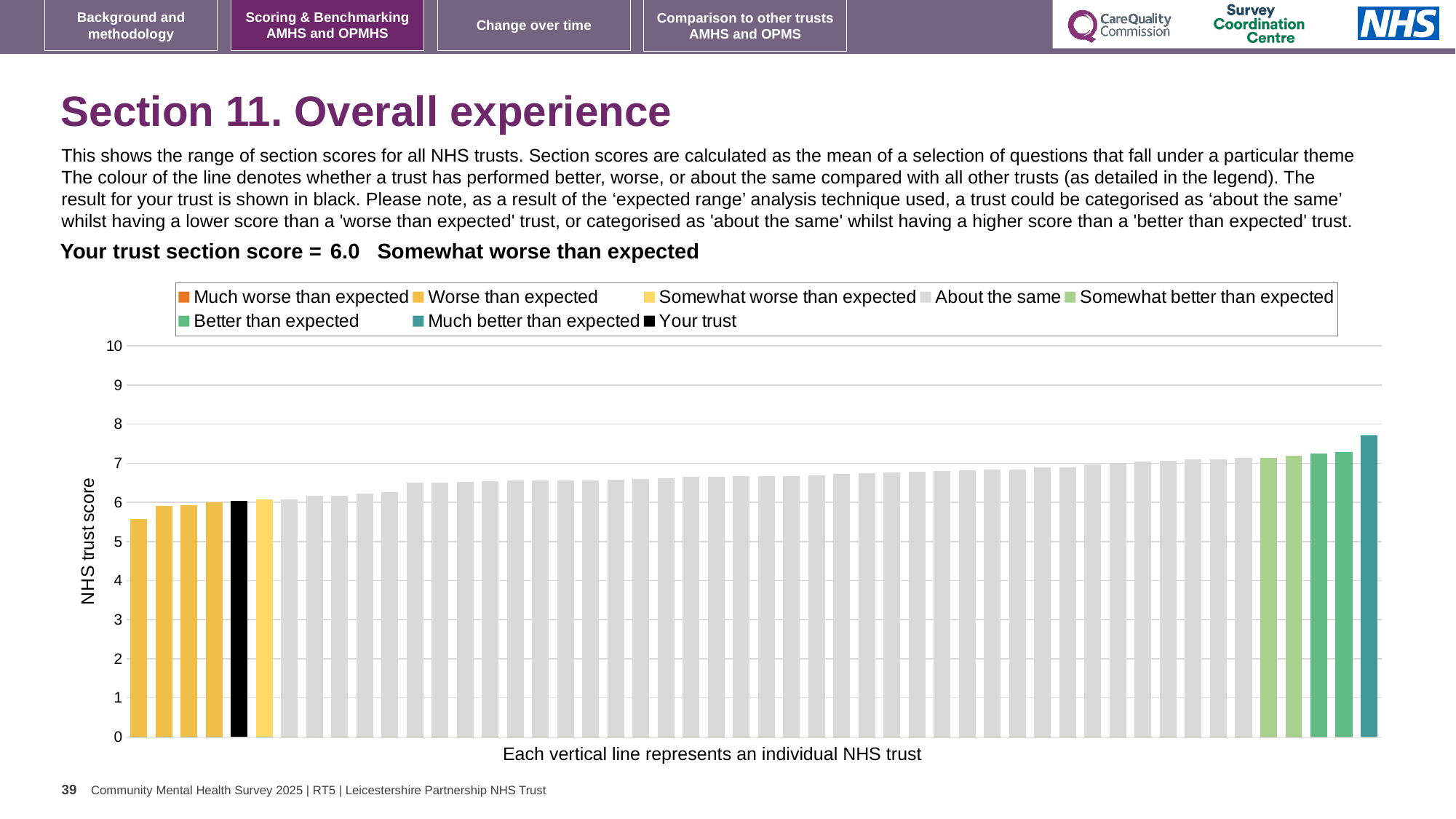
Is the value of the leftmost bar (the lowest-scoring trust) greater or less than 6? less What is the label on the vertical axis of the chart? NHS trust score How many entries does the chart legend list? 8 Is the value of the tallest bar greater or less than 8? less Do the bar values rise or fall from left to right along the x axis? Rise Is the value of the tallest bar (the rightmost, 'Much better than expected' trust) greater or less than 7? greater Which bar is higher: the black 'Your trust' bar or the rightmost teal bar? The rightmost teal bar Which legend category does the black bar represent? Your trust What type of chart is shown on the slide? Bar chart What is the section score for your trust shown on the slide? 6.0 Which bar is lower: the leftmost bar or the black 'Your trust' bar? The leftmost bar